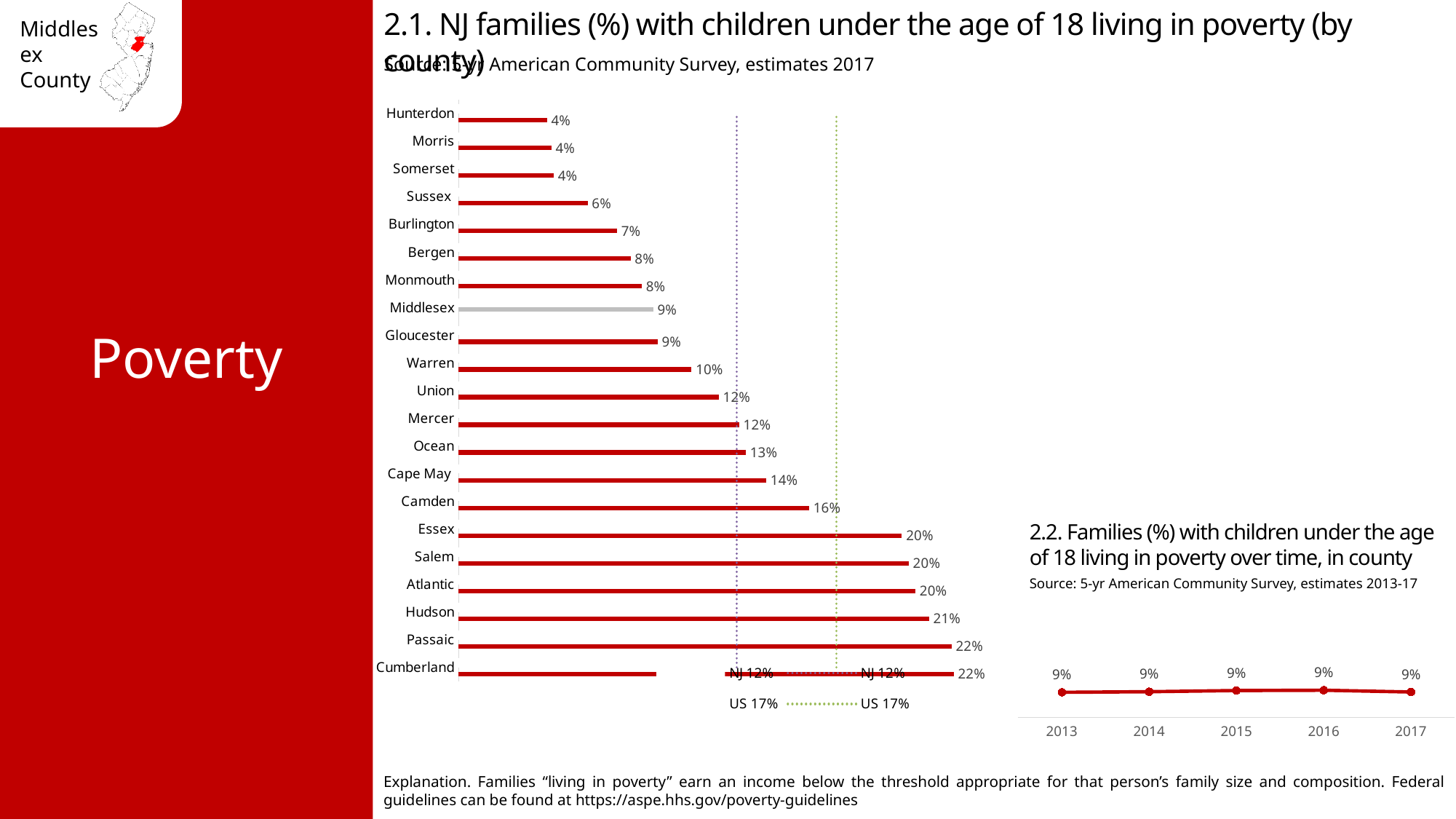
In chart 2.1, what is the value shown for Hudson? 21% In chart 2.2, how many years are plotted? 5 In chart 2.2, what is the value for 2015? 9% In chart 2.1, what percentage of families with children under 18 live in poverty in Middlesex County? 9% In chart 2.1, what is the value shown for Camden? 16% What kind of chart is chart 2.1? Bar chart In chart 2.1, what is the difference between the values for Passaic and Hunterdon? 18% In chart 2.1, what value is shown for the NJ reference line? 12% In chart 2.1, what value is shown for the US reference line? 17% In chart 2.1, which has a higher value, Essex or Cape May? Essex In chart 2.2, do the values rise, fall, or stay flat from 2013 to 2017? Stay flat In chart 2.1, how many counties are plotted? 21